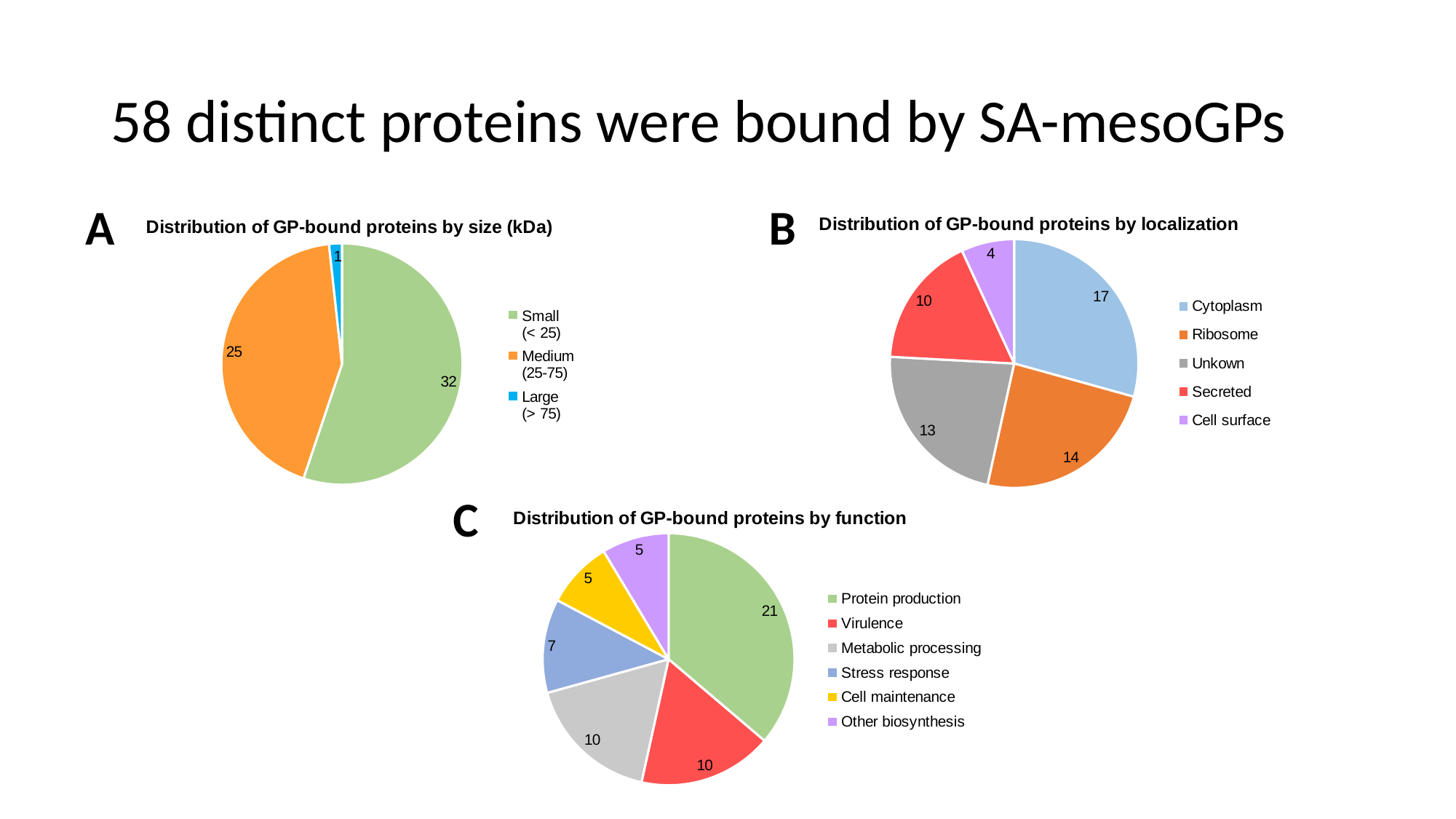
In the chart 'Distribution of GP-bound proteins by localization', how many categories does the legend list? 5 In the chart 'Distribution of GP-bound proteins by localization', which is larger, Ribosome or Unkown? Ribosome In the chart 'Distribution of GP-bound proteins by function', what is the difference between Protein production and Virulence? 11 In the chart 'Distribution of GP-bound proteins by localization', what is the value for Secreted? 10 In the chart 'Distribution of GP-bound proteins by size (kDa)', which category has the smallest slice? Large (> 75) In the chart 'Distribution of GP-bound proteins by size (kDa)', what is the difference between the Small (< 25) and Medium (25-75) values? 7 What type of chart is used for 'Distribution of GP-bound proteins by function'? Pie chart In the chart 'Distribution of GP-bound proteins by size (kDa)', what is the value for Medium (25-75)? 25 In the chart 'Distribution of GP-bound proteins by localization', which category has the largest slice? Cytoplasm In the chart 'Distribution of GP-bound proteins by function', what is the value for Stress response? 7 In the chart 'Distribution of GP-bound proteins by function', which category has the largest slice? Protein production In the chart 'Distribution of GP-bound proteins by function', how many categories are shown? 6